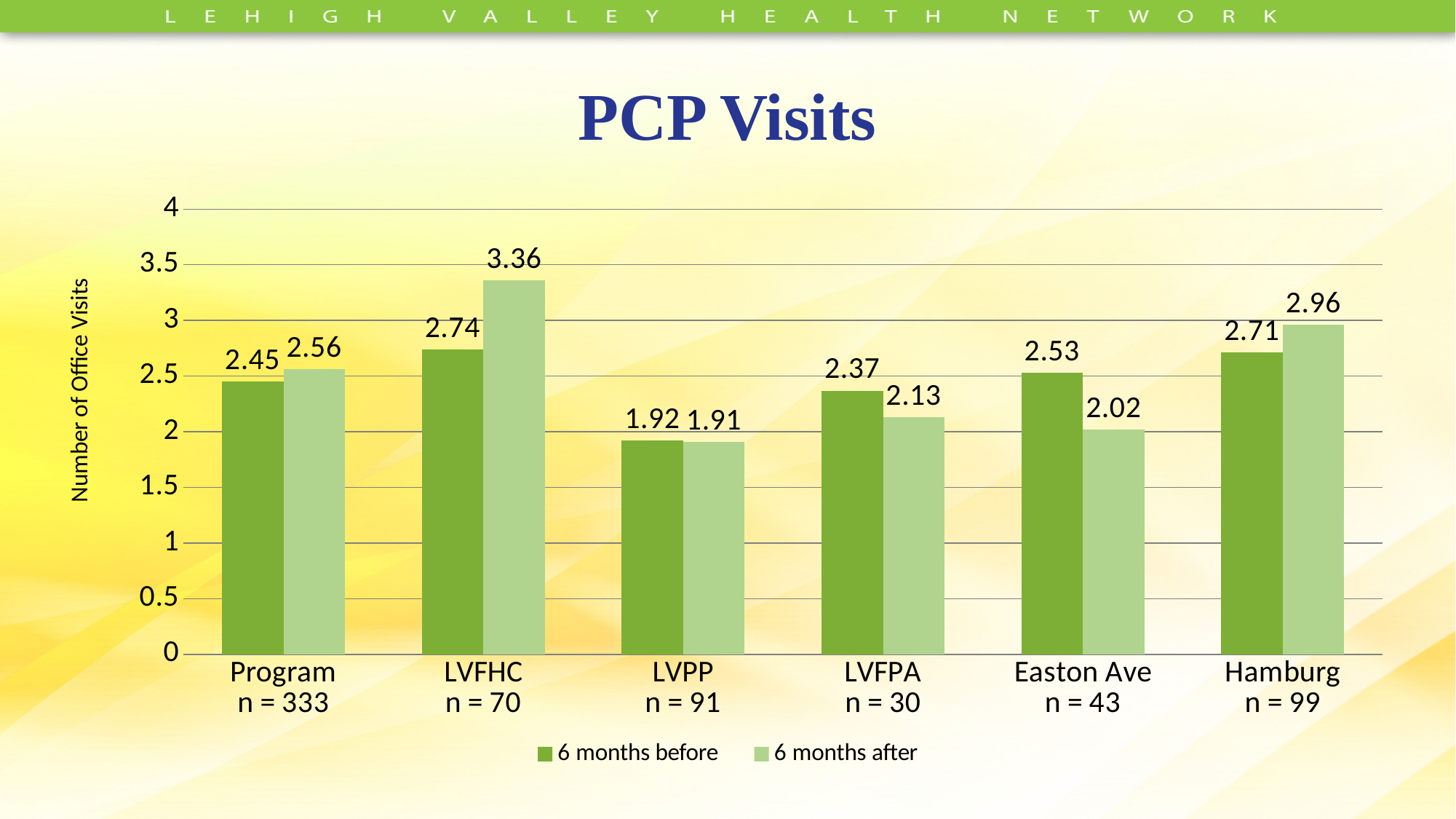
What is the value for '6 months before' for Easton Ave? 2.53 Which category has the lowest '6 months before' value? LVPP How many categories are shown on the x axis? 6 What kind of chart is shown on the slide? bar chart Which is larger for Easton Ave: the '6 months before' value or the '6 months after' value? 6 months before Is the '6 months after' value for LVFHC greater or less than 3? greater What is the title of the chart? PCP Visits Which category has the highest '6 months after' value? LVFHC What is the value for '6 months after' for LVFHC? 3.36 What is the value for '6 months after' for Hamburg? 2.96 How many series does the legend list? 2 What is the difference between the '6 months after' and '6 months before' values for LVFHC? 0.62